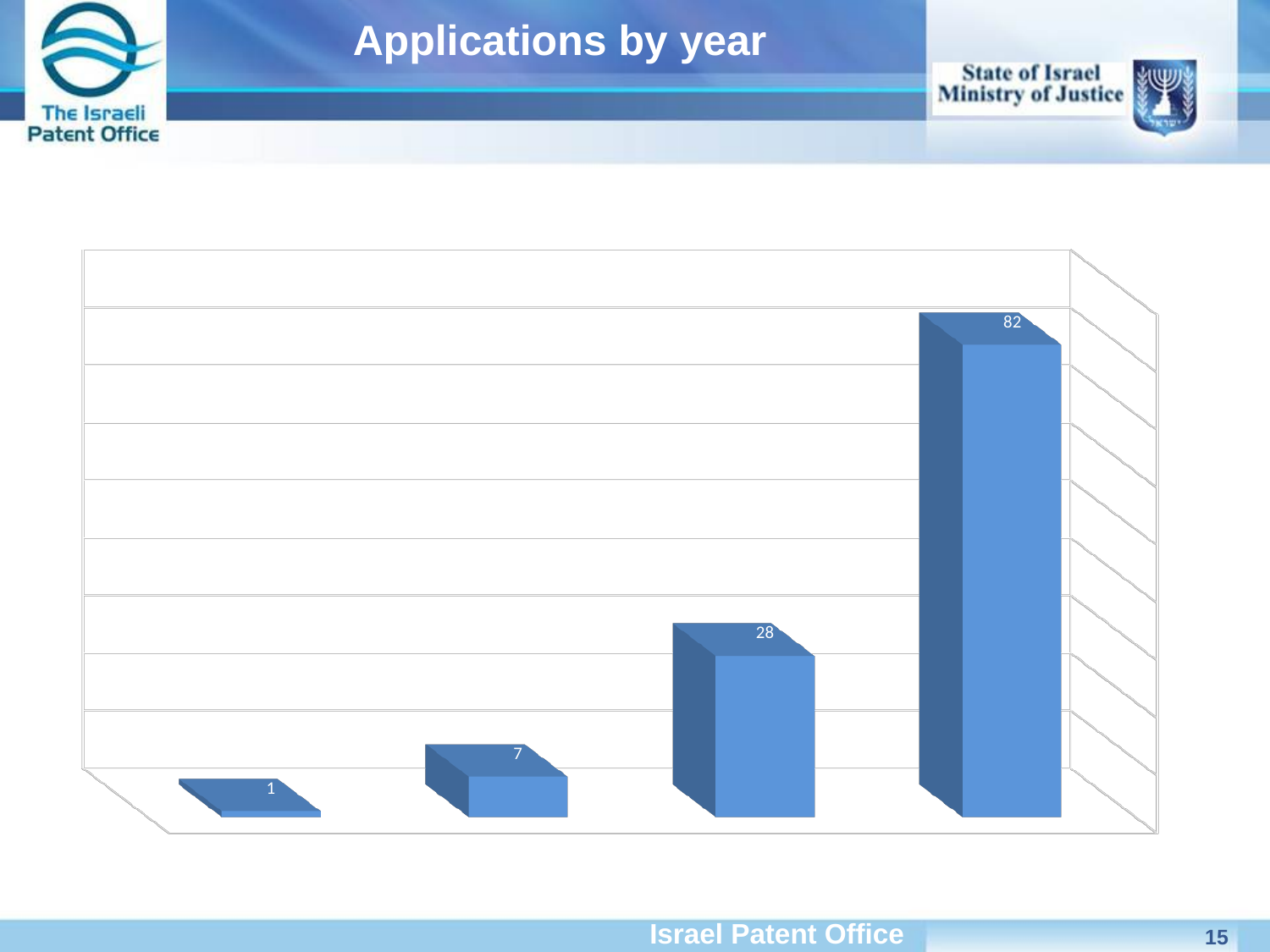
What value is shown on the second bar from the left? 7 Do the values rise or fall from left to right across the bars? Rise What value is shown on the first bar from the left? 1 What kind of chart is shown on the slide? Bar chart Which bar has the highest value? The rightmost (fourth) bar, 82 What is the difference between the values of the rightmost bar and the third bar? 54 What is the difference between the values of the second and first bars? 6 What value is shown on the rightmost bar? 82 How many bars are plotted in the chart? 4 Which bar has the lowest value? The leftmost (first) bar, 1 Which is larger, the value of the third bar or the second bar? The third bar (28) What value is shown on the third bar from the left? 28